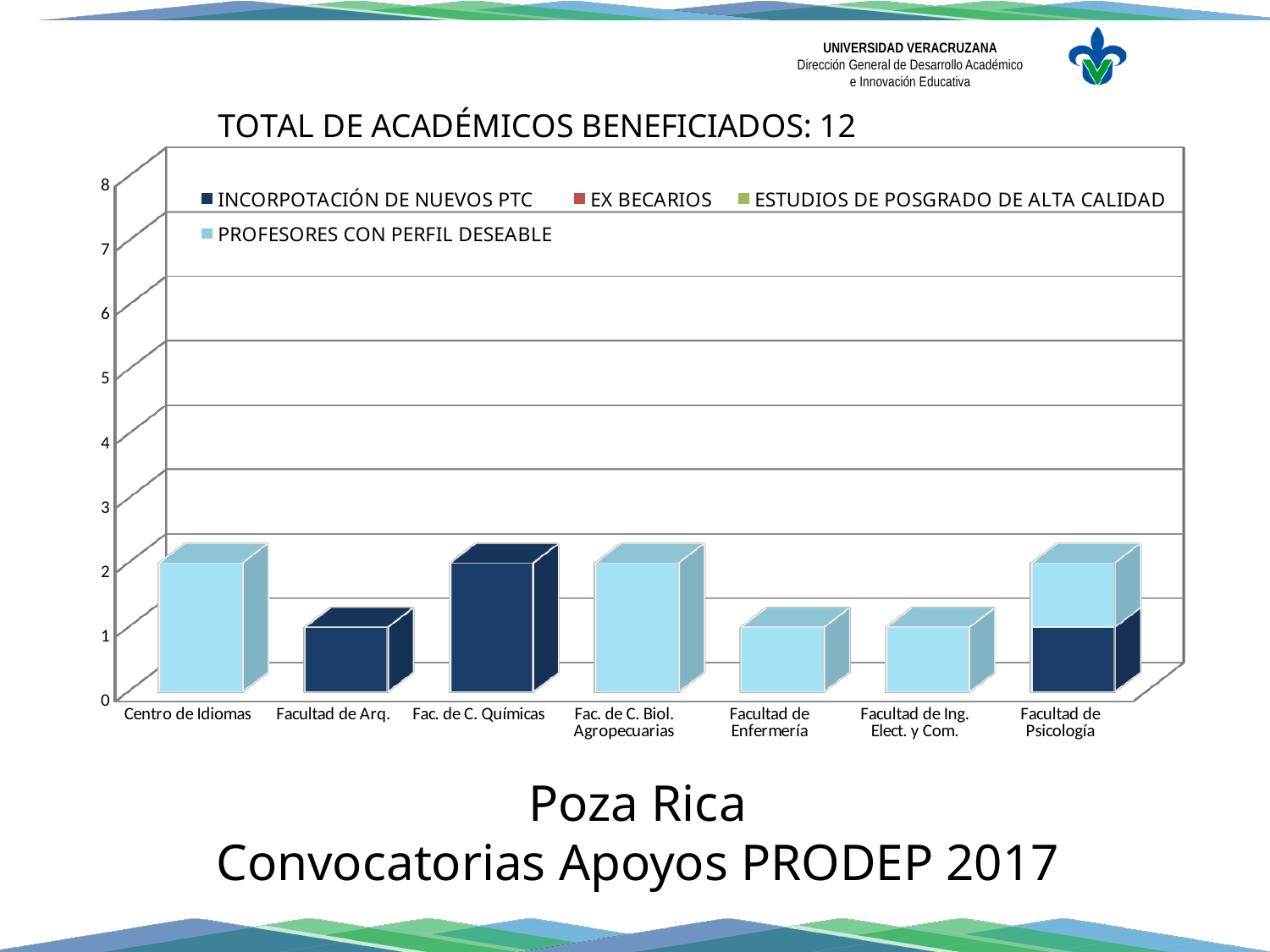
How many series does the legend list? 4 What is the value for Facultad de Arq.? 1 What is the value for Fac. de C. Químicas? 2 What kind of chart is shown on the slide? bar chart Which is larger, the value for Fac. de C. Biol. Agropecuarias or the value for Facultad de Ing. Elect. y Com.? Fac. de C. Biol. Agropecuarias What is the total of the stacked bar for Facultad de Psicología? 2 What is the value for Facultad de Enfermería? 1 What is the title of the chart? TOTAL DE ACADÉMICOS BENEFICIADOS: 12 Is the value for Fac. de C. Químicas greater or less than 4? less How many categories are shown on the x axis? 7 What is the value for Centro de Idiomas? 2 Which series does the bar for Facultad de Arq. belong to? INCORPOTACIÓN DE NUEVOS PTC